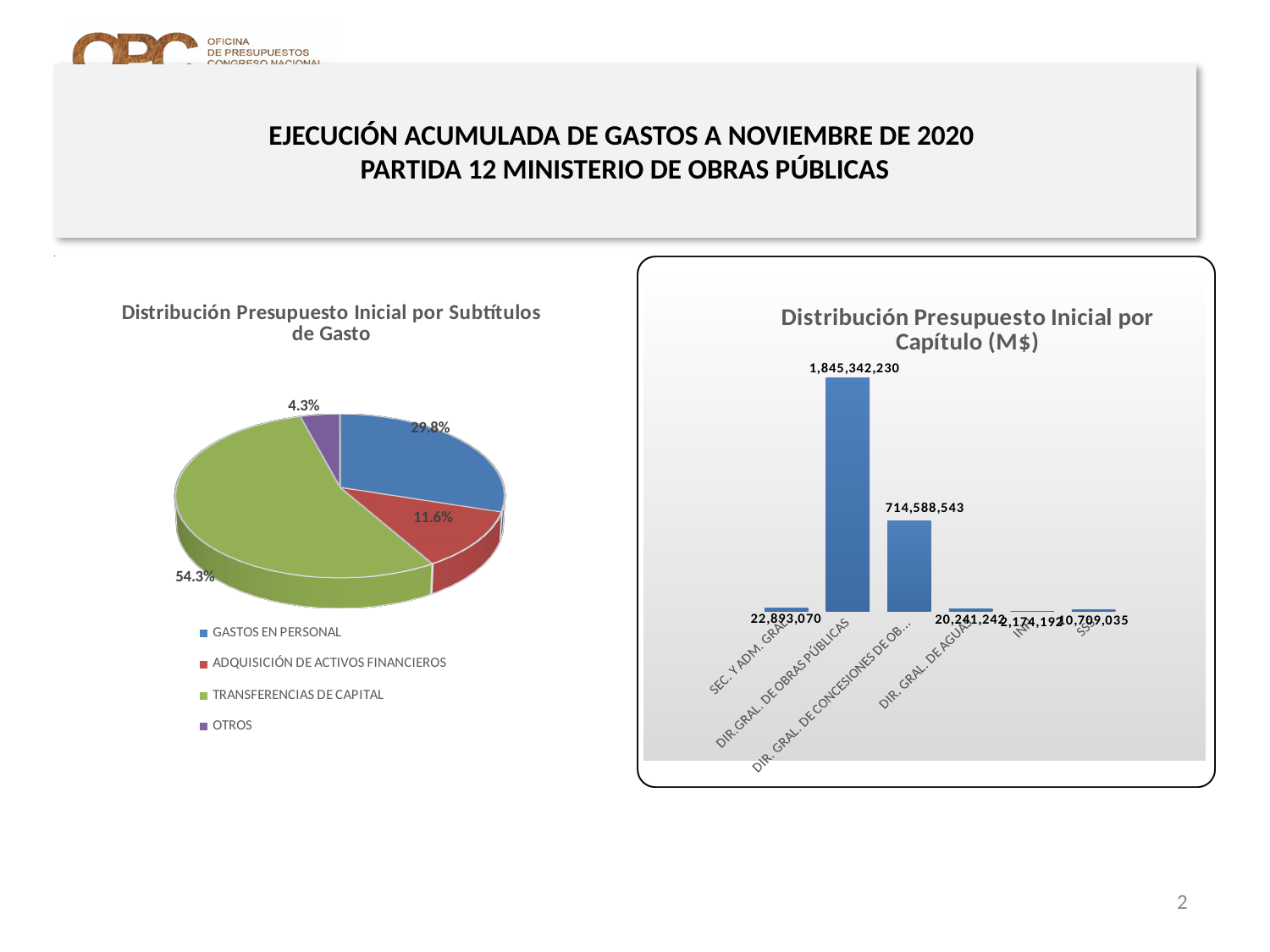
In the chart 'Distribución Presupuesto Inicial por Capítulo (M$)', what is the value for DIR.GRAL. DE OBRAS PÚBLICAS? 1,845,342,230 In the chart 'Distribución Presupuesto Inicial por Capítulo (M$)', which chapter has the highest value? DIR.GRAL. DE OBRAS PÚBLICAS In the pie chart 'Distribución Presupuesto Inicial por Subtítulos de Gasto', which category has the smallest slice? OTROS In the pie chart 'Distribución Presupuesto Inicial por Subtítulos de Gasto', which category has the largest slice? TRANSFERENCIAS DE CAPITAL In the chart 'Distribución Presupuesto Inicial por Capítulo (M$)', what is the value for SEC. Y ADM. GRAL.? 22,893,070 What kind of chart is the one on the left of the slide, 'Distribución Presupuesto Inicial por Subtítulos de Gasto'? Pie chart In the pie chart 'Distribución Presupuesto Inicial por Subtítulos de Gasto', how many categories does the legend list? 4 What kind of chart is 'Distribución Presupuesto Inicial por Capítulo (M$)'? Bar chart In the pie chart 'Distribución Presupuesto Inicial por Subtítulos de Gasto', what share does GASTOS EN PERSONAL have? 29.8% In the pie chart 'Distribución Presupuesto Inicial por Subtítulos de Gasto', what share does TRANSFERENCIAS DE CAPITAL have? 54.3% In the chart 'Distribución Presupuesto Inicial por Capítulo (M$)', how many bars are plotted? 6 In the pie chart 'Distribución Presupuesto Inicial por Subtítulos de Gasto', what is the difference in percentage points between TRANSFERENCIAS DE CAPITAL and GASTOS EN PERSONAL? 24.5 percentage points